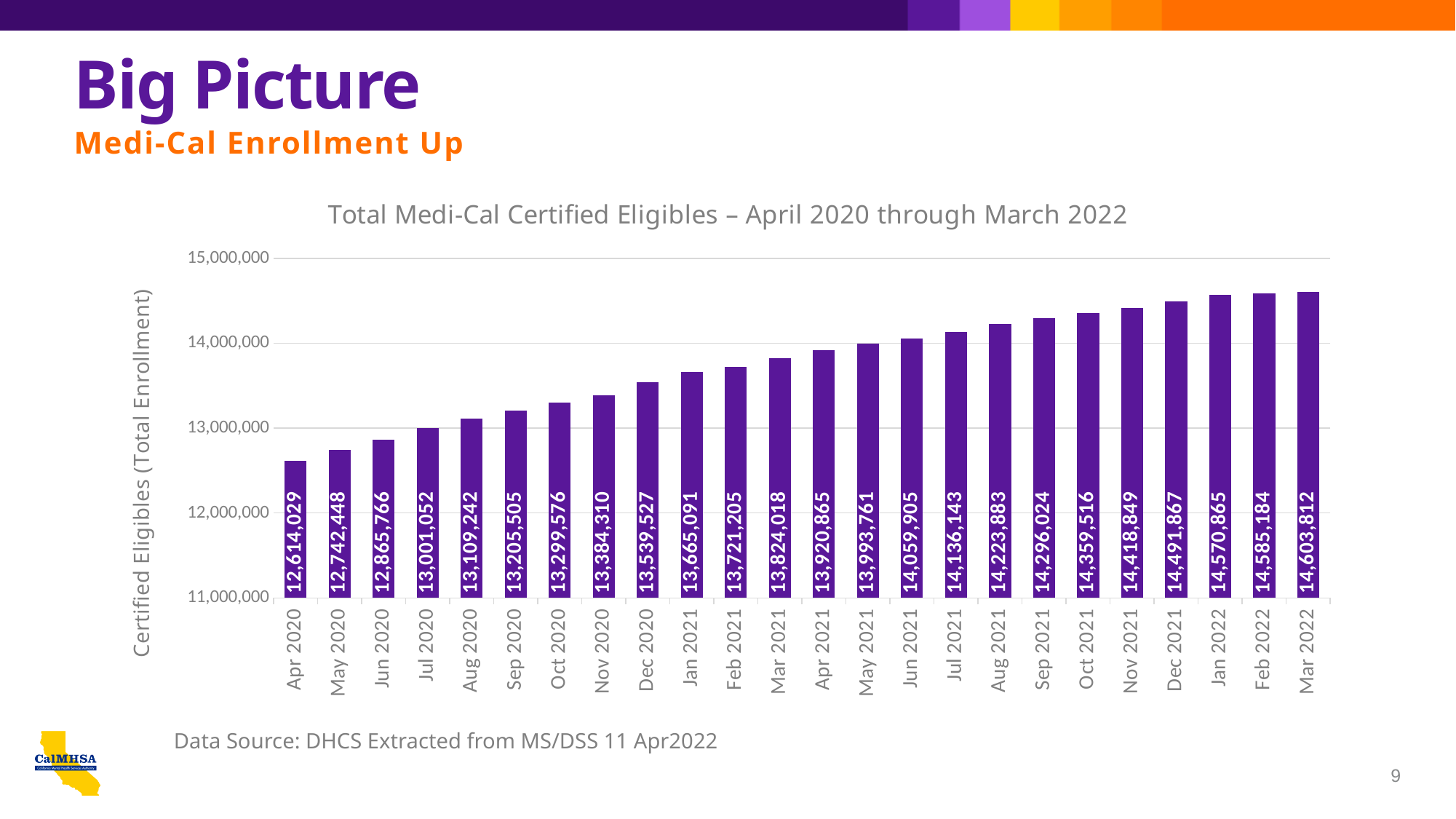
What is the value for Sep 2021? 14,296,024 Which month has the highest number of certified eligibles? Mar 2022 What kind of chart is this? Bar chart What is the difference between the values for Mar 2022 and Apr 2020? 1,989,783 What is the difference between the values for Jan 2021 and Dec 2020? 125,564 What is the value for Mar 2022? 14,603,812 Do the values rise or fall from Apr 2020 to Mar 2022? Rise How many months are shown on the x axis? 24 Which is larger, the value for Jul 2020 or the value for Jul 2021? Jul 2021 What is the value for Apr 2020? 12,614,029 Which month has the lowest number of certified eligibles? Apr 2020 What is the value for Jan 2021? 13,665,091